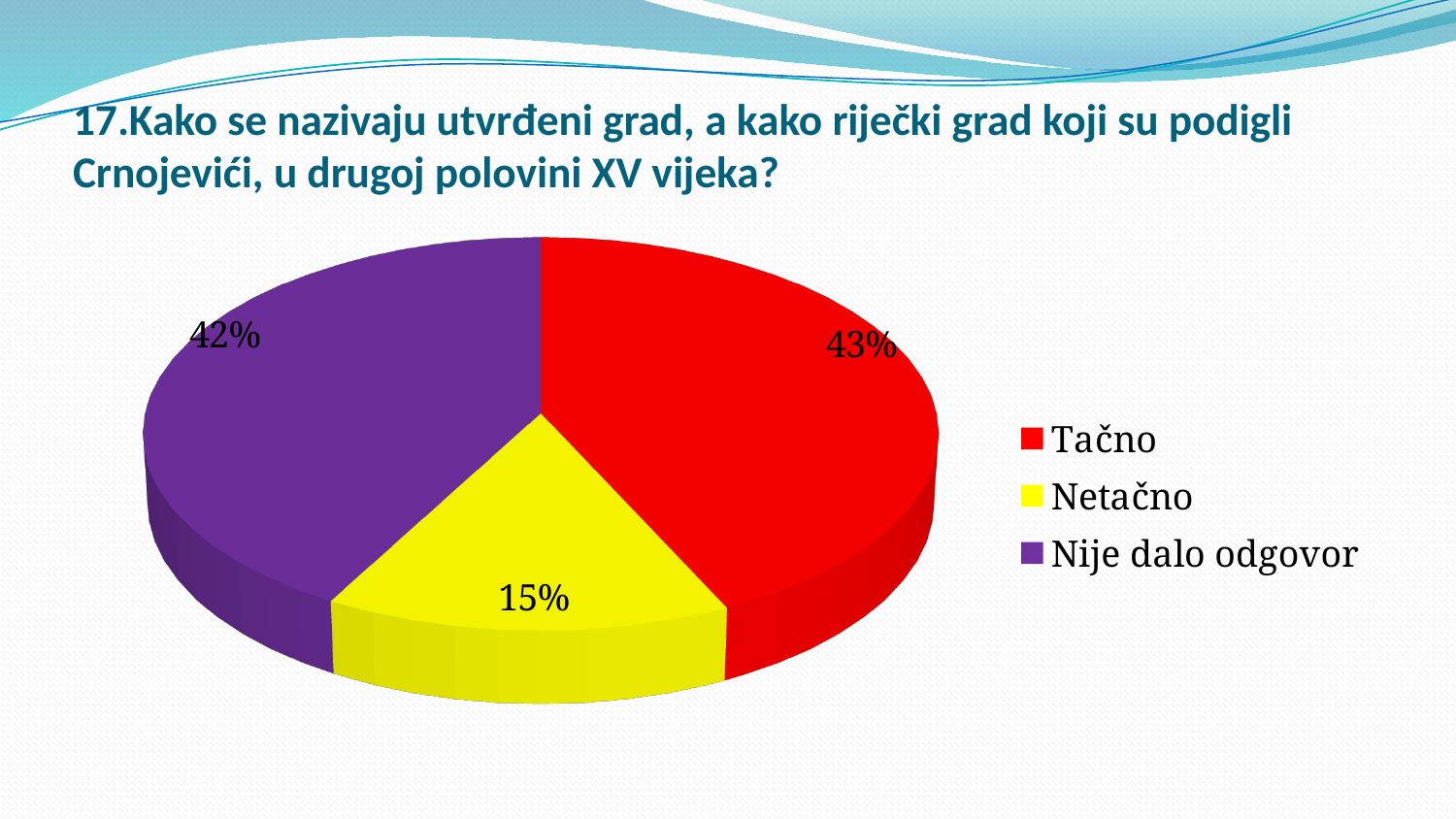
What kind of chart is shown on the slide? Pie chart What is the difference in percentage points between Tačno and Nije dalo odgovor? 1 What is the difference in percentage points between Tačno and Netačno? 28 What share of the pie does Nije dalo odgovor represent? 42% What share of the pie does Tačno represent? 43% Which is larger, the share for Nije dalo odgovor or the share for Netačno? Nije dalo odgovor How many entries does the legend list? 3 Which category has the smallest slice of the pie? Netačno How many slices does the pie chart have? 3 What share of the pie does Netačno represent? 15% What colour is the slice for Nije dalo odgovor? Purple Which category has the largest slice of the pie? Tačno